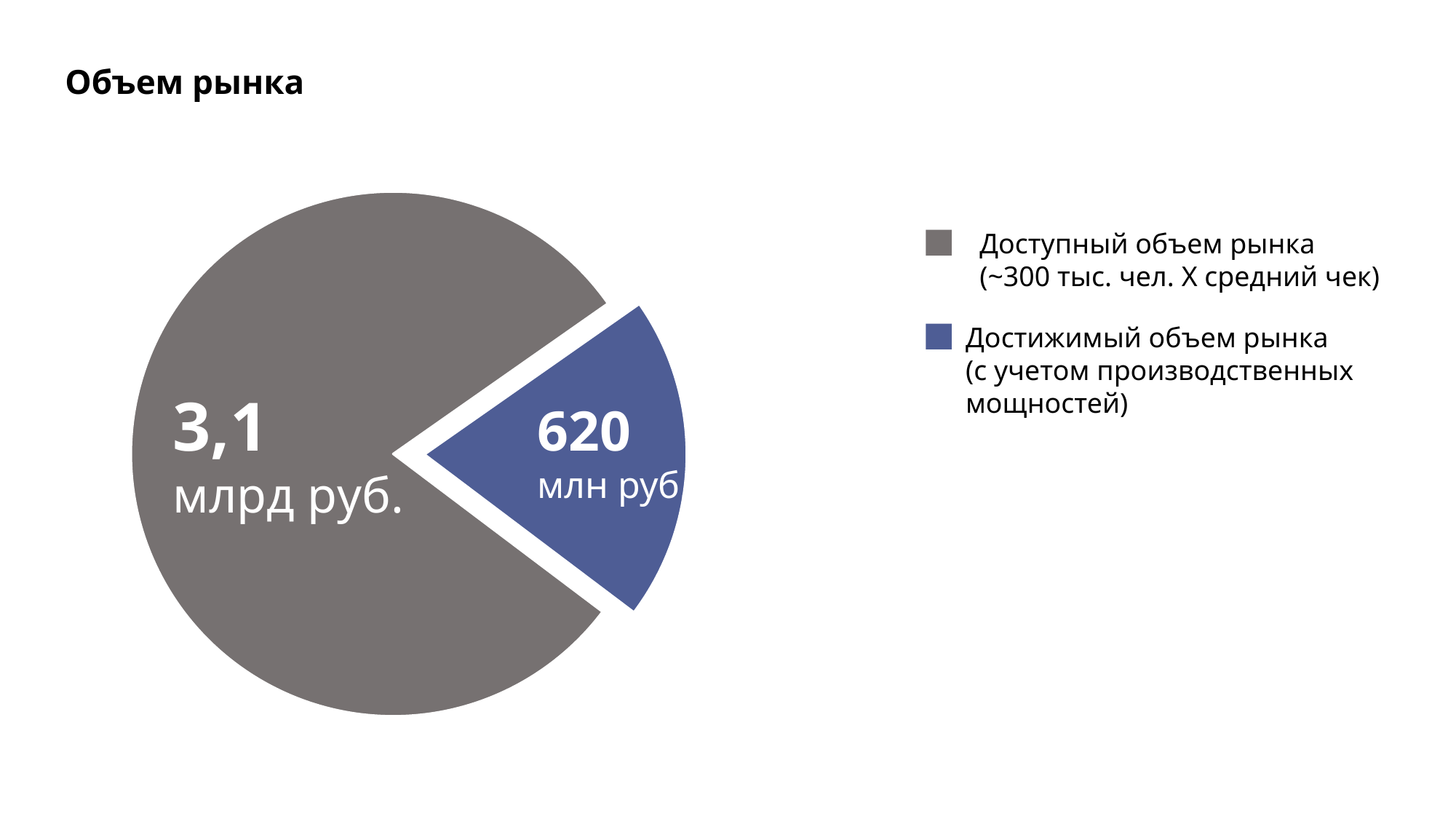
Which is larger: Доступный объем рынка or Достижимый объем рынка? Доступный объем рынка What is the title of the chart? Объем рынка Which slice is the smallest? Достижимый объем рынка What value is shown for Доступный объем рынка? 3,1 млрд руб. What value is shown for Достижимый объем рынка? 620 млн руб Which slice is the largest? Доступный объем рынка How many entries does the legend list? 2 How many slices does the pie chart have? 2 What colour is the slice for Достижимый объем рынка? blue What kind of chart is shown on the slide? pie chart